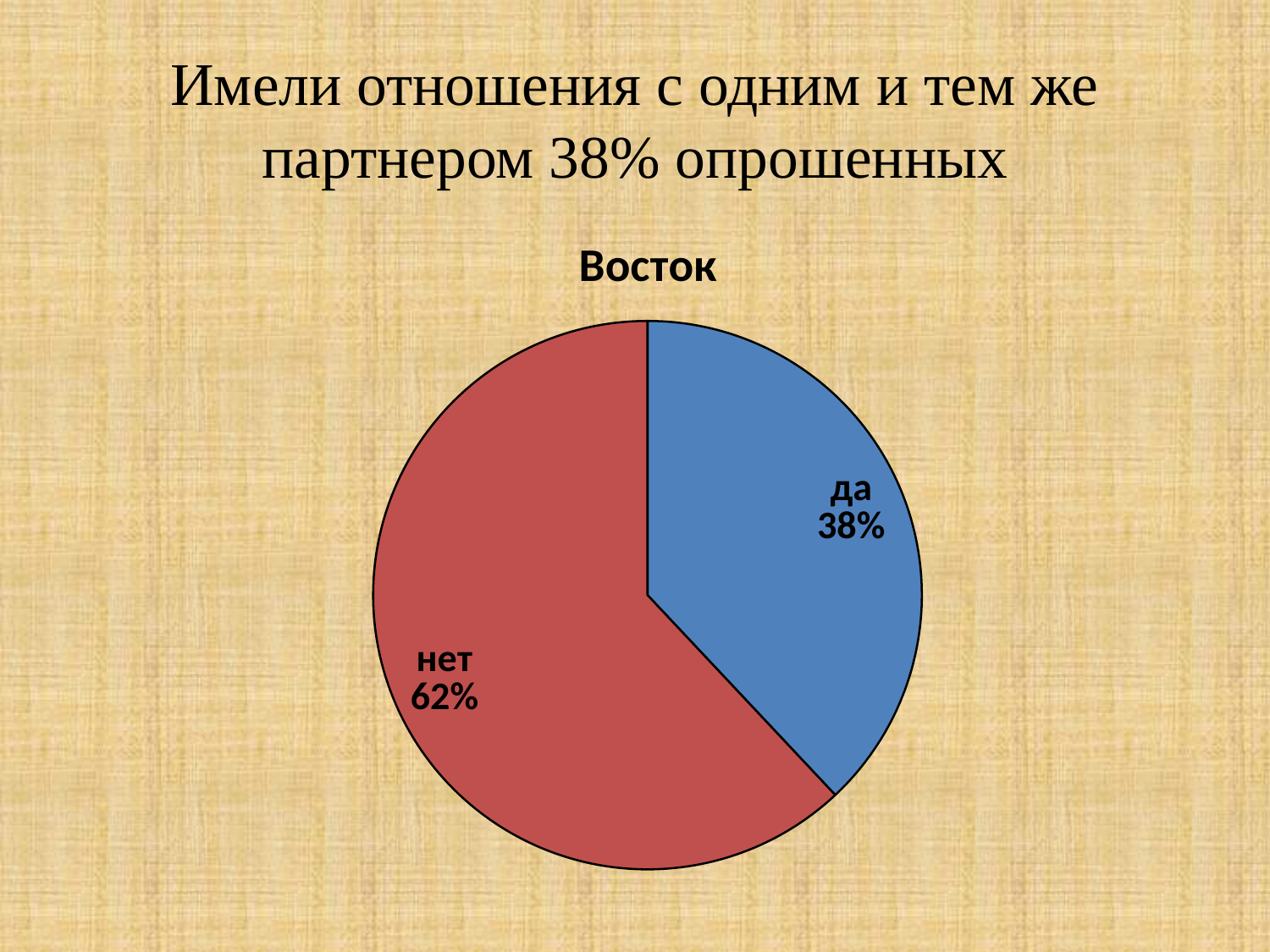
What is the total of the two slices in the pie chart? 100% Which slice is the smallest in the pie chart? да How many slices does the pie chart have? 2 Is the share for "нет" greater or less than 50%? greater What kind of chart is shown on the slide? pie chart What share of the pie does the "да" slice represent? 38% What is the title of the chart? Восток Which is larger, the "да" slice or the "нет" slice? нет What share of the pie does the "нет" slice represent? 62% What is the difference between the "нет" and "да" shares? 24% What colour is the "да" slice? blue Which slice is the largest in the pie chart? нет